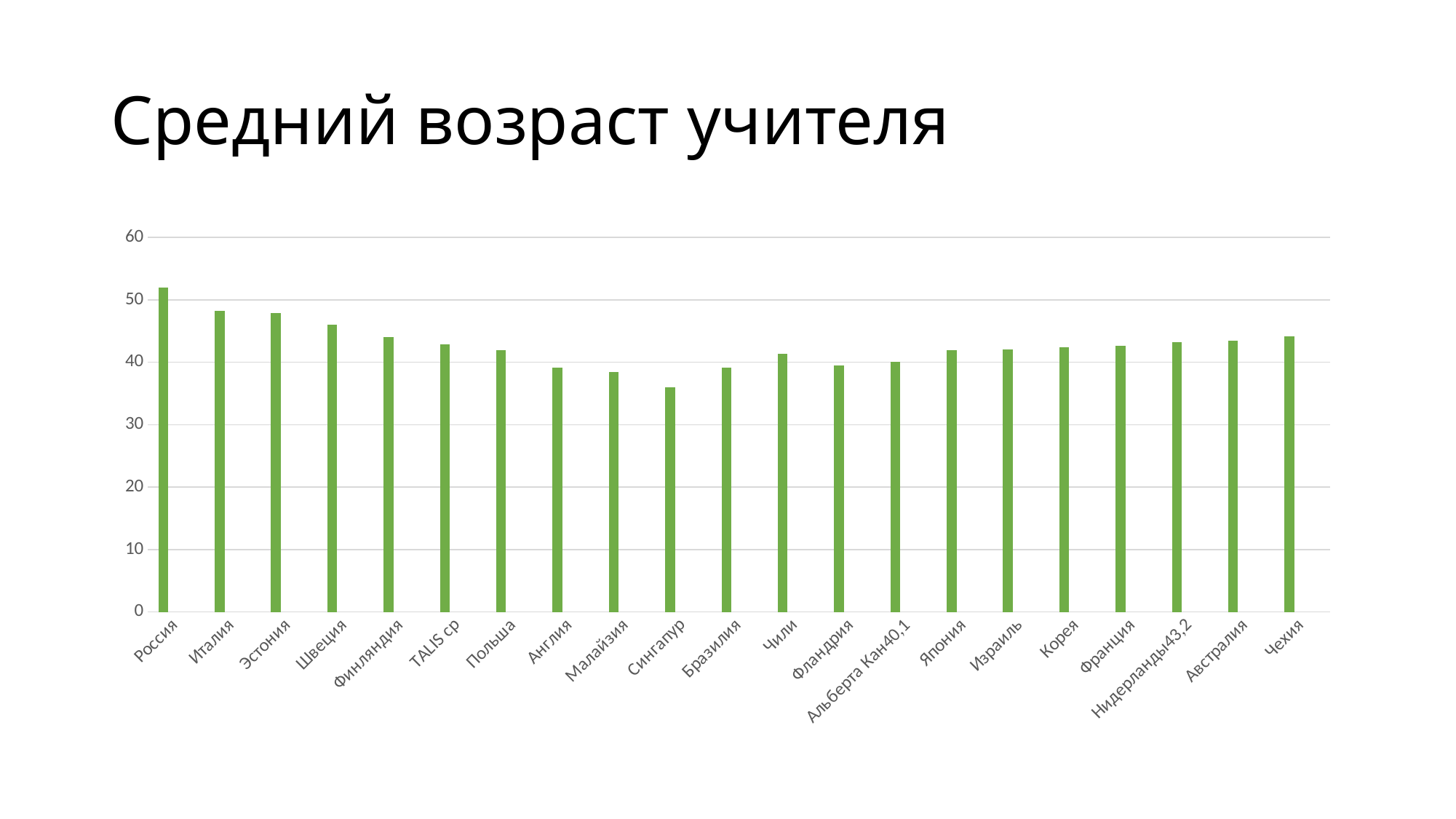
Which category has the lowest bar? Сингапур Which category has the highest bar? Россия What kind of chart is shown on the slide? bar chart Do the values rise or fall along the x axis from Россия to Сингапур? fall Which is larger, the value for Италия or the value for Англия? Италия What colour are the bars in the chart? green Is the value for Сингапур greater or less than 40? less Is the value for Россия greater or less than 50? greater What is the title of the chart? Средний возраст учителя Is the value for Чехия greater or less than 40? greater How many categories (bars) are shown in the chart? 21